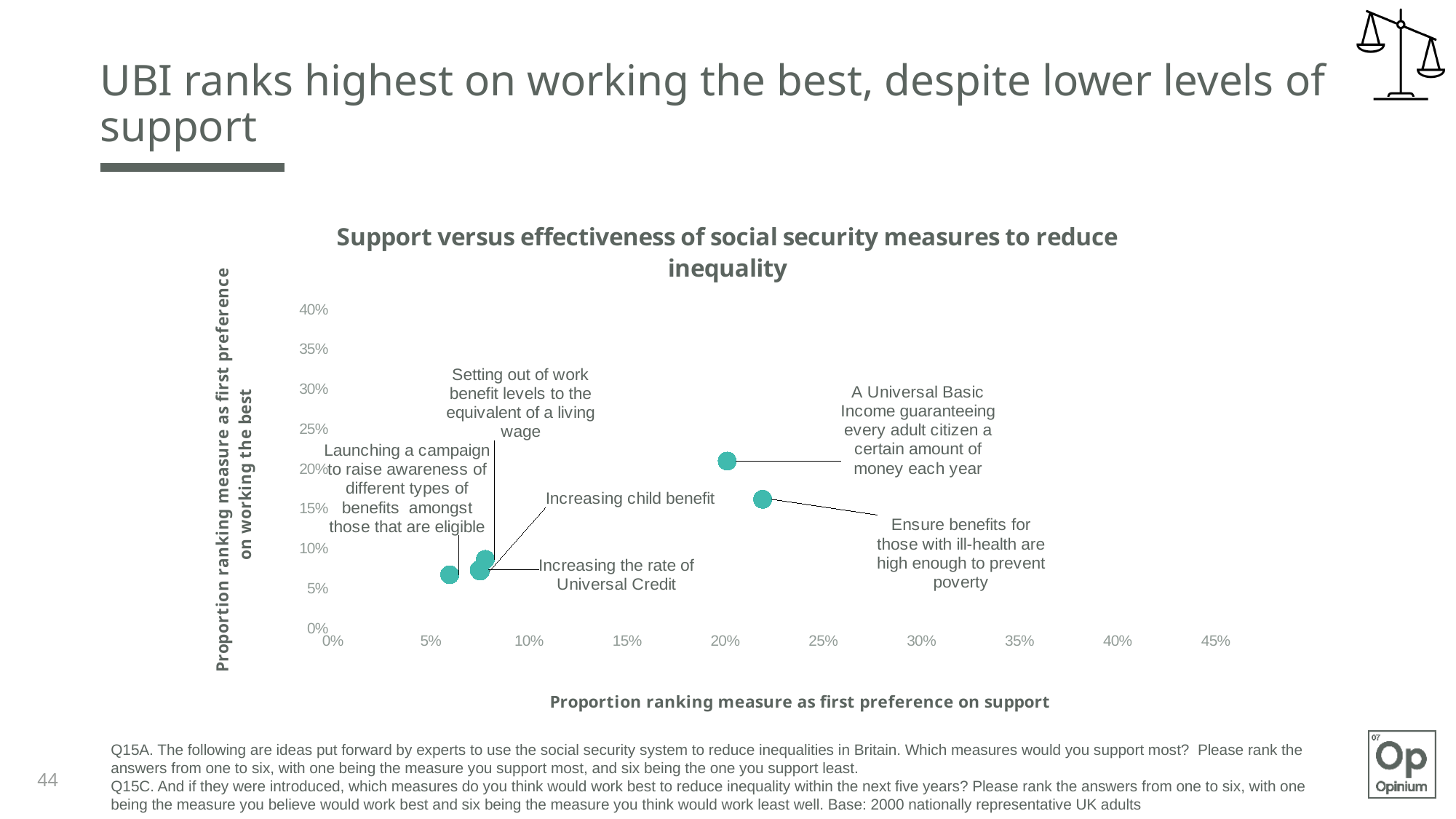
Which measure has the lowest proportion ranking it as first preference on support? Launching a campaign to raise awareness of different types of benefits amongst those that are eligible Is the proportion ranking 'Increasing child benefit' as first preference on working the best greater or less than 10%? less Which has a higher proportion ranking it first on support: Universal Basic Income or Increasing child benefit? A Universal Basic Income guaranteeing every adult citizen a certain amount of money each year Is the proportion ranking Universal Basic Income as first preference on working the best greater or less than 15%? greater What kind of chart is shown on the slide? scatter chart Is the proportion ranking 'Ensure benefits for those with ill-health are high enough to prevent poverty' as first preference on support greater or less than 20%? greater What is the title of the chart? Support versus effectiveness of social security measures to reduce inequality Which ranks higher on working the best: Universal Basic Income or Ensure benefits for those with ill-health are high enough to prevent poverty? A Universal Basic Income guaranteeing every adult citizen a certain amount of money each year Which measure has the highest proportion ranking it as first preference on support? Ensure benefits for those with ill-health are high enough to prevent poverty Which measure has the highest proportion ranking it as first preference on working the best? A Universal Basic Income guaranteeing every adult citizen a certain amount of money each year How many data points are plotted on the chart? 6